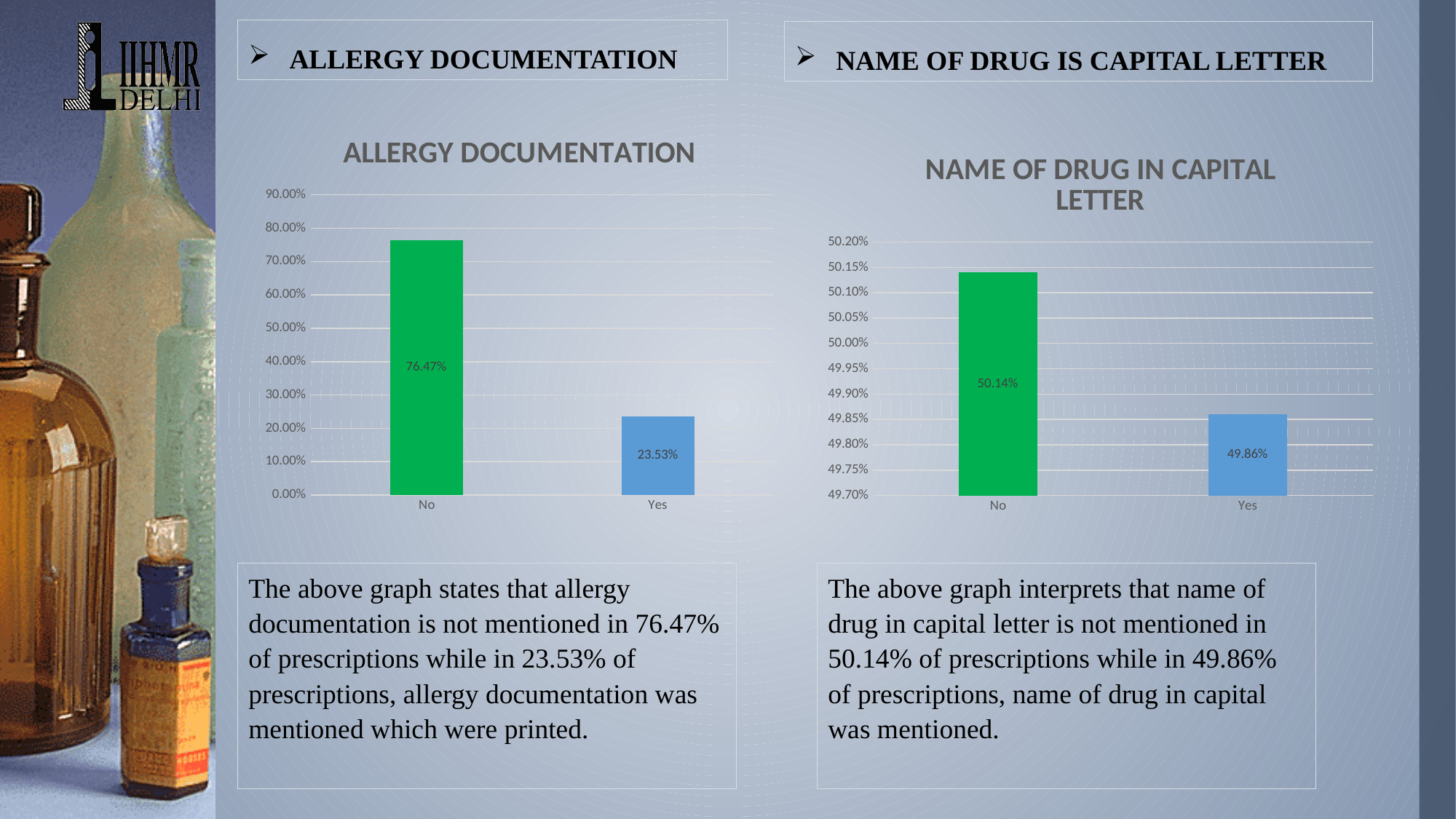
How many categories are shown in the ALLERGY DOCUMENTATION chart? 2 In the NAME OF DRUG IN CAPITAL LETTER chart, what colour is the bar for No? green What type of chart is the NAME OF DRUG IN CAPITAL LETTER chart? bar chart In the ALLERGY DOCUMENTATION chart, what is the value for No? 76.47% In the ALLERGY DOCUMENTATION chart, what is the value for Yes? 23.53% In the ALLERGY DOCUMENTATION chart, which category has the highest value? No In the NAME OF DRUG IN CAPITAL LETTER chart, what is the difference between the values for No and Yes? 0.28% In the NAME OF DRUG IN CAPITAL LETTER chart, which category has the lowest value? Yes In the ALLERGY DOCUMENTATION chart, is the value for Yes greater or less than 30.00%? less In the NAME OF DRUG IN CAPITAL LETTER chart, what is the value for Yes? 49.86% In the NAME OF DRUG IN CAPITAL LETTER chart, what is the value for No? 50.14% In the ALLERGY DOCUMENTATION chart, what is the difference between the values for No and Yes? 52.94%